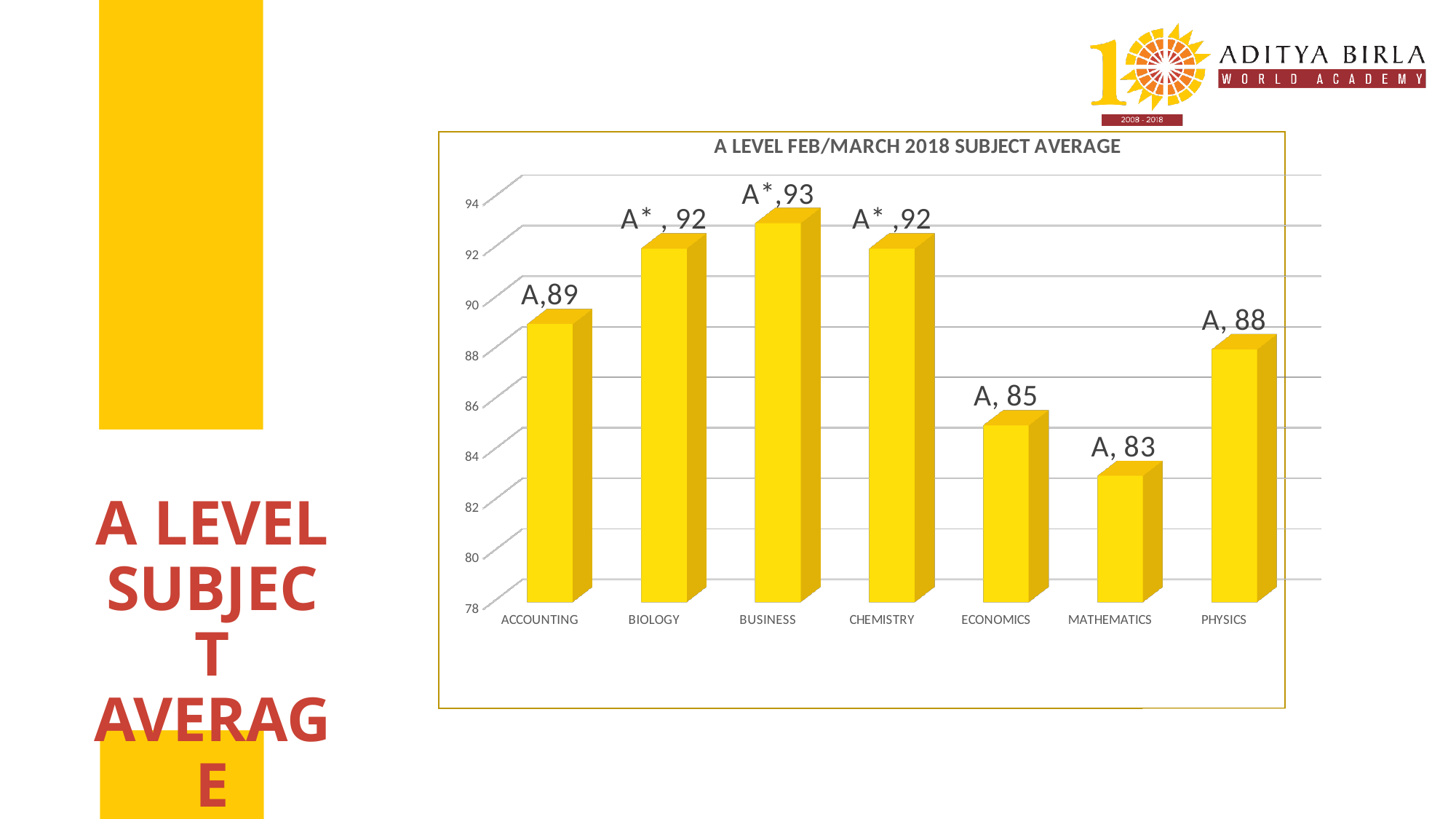
What kind of chart is shown on the slide? Bar chart How many subjects are shown in the chart? 7 What is the subject average for Mathematics? 83 Which has a higher average, Economics or Physics? Physics Which subject has the lowest average? Mathematics What is the subject average for Business? 93 Is the value for Chemistry greater or less than 90? greater What is the difference between the averages for Accounting and Physics? 1 What is the subject average for Economics? 85 Which subject has the highest average? Business What is the title of the chart? A LEVEL FEB/MARCH 2018 SUBJECT AVERAGE What is the difference between the averages for Business and Mathematics? 10